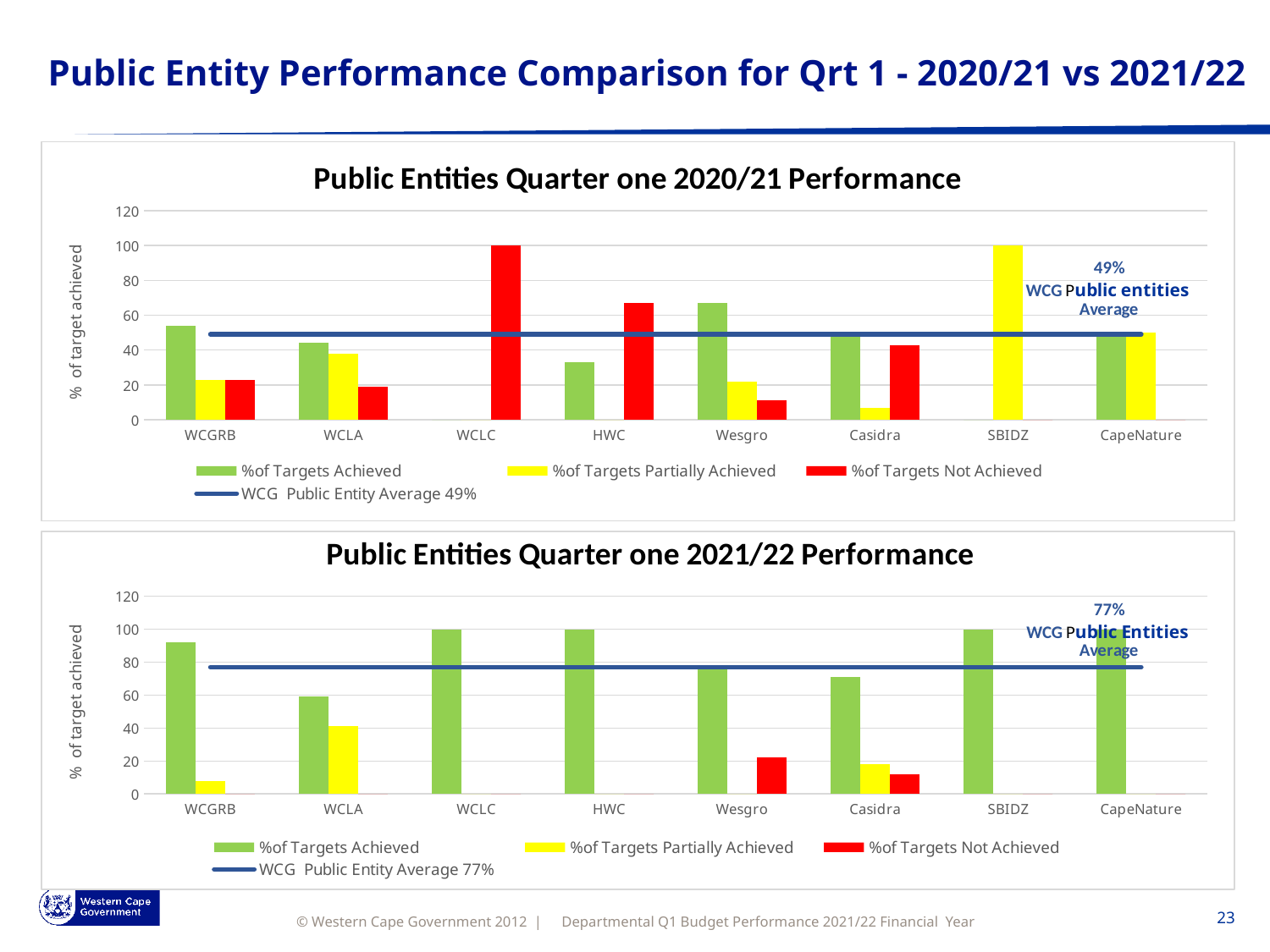
In the 'Public Entities Quarter one 2021/22 Performance' chart, which is larger: the % of Targets Achieved for WCGRB or for Casidra? WCGRB How many entries does the legend of the 'Public Entities Quarter one 2020/21 Performance' chart list? 4 What type of chart is the 'Public Entities Quarter one 2020/21 Performance' chart? bar chart How many public entities are shown on the x axis of the 'Public Entities Quarter one 2021/22 Performance' chart? 8 In the 'Public Entities Quarter one 2020/21 Performance' chart, what is the WCG Public Entity Average shown? 49% In the 'Public Entities Quarter one 2021/22 Performance' chart, what is the WCG Public Entity Average shown? 77% In the 'Public Entities Quarter one 2021/22 Performance' chart, is the % of Targets Achieved for WCLA greater or less than 80? less In the 'Public Entities Quarter one 2021/22 Performance' chart, what is the % of Targets Achieved for HWC? 100 In the 'Public Entities Quarter one 2020/21 Performance' chart, which colour represents % of Targets Not Achieved? red In the 'Public Entities Quarter one 2020/21 Performance' chart, which entity has the highest % of Targets Partially Achieved? SBIDZ In the 'Public Entities Quarter one 2020/21 Performance' chart, what is the % of Targets Not Achieved for WCLC? 100 In the 'Public Entities Quarter one 2020/21 Performance' chart, is the % of Targets Achieved for Wesgro greater or less than 60? greater